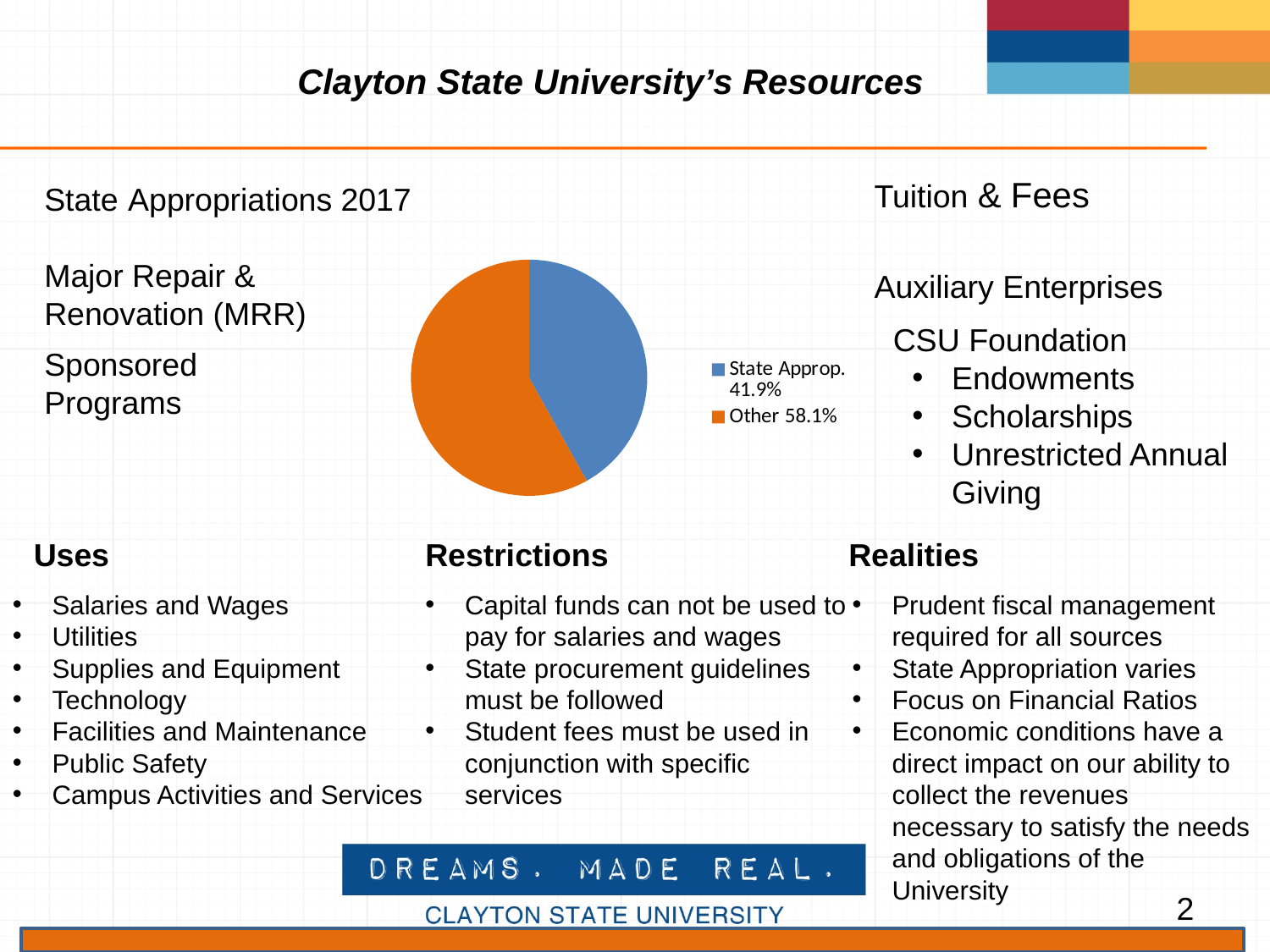
Which slice of the pie is the largest? Other What kind of chart is shown on the slide? pie chart Which slice of the pie is the smallest? State Approp. Is the State Approp. share of the pie greater or less than 50%? less Which is larger, the State Approp. slice or the Other slice? Other What colour is the Other slice in the pie chart? orange How many slices does the pie chart have? 2 What colour is the State Approp. slice in the pie chart? blue What is the difference in percentage points between the Other slice and the State Approp. slice? 16.2 How many entries does the pie chart's legend list? 2 What share of the pie does State Approp. represent? 41.9% What share of the pie does Other represent? 58.1%